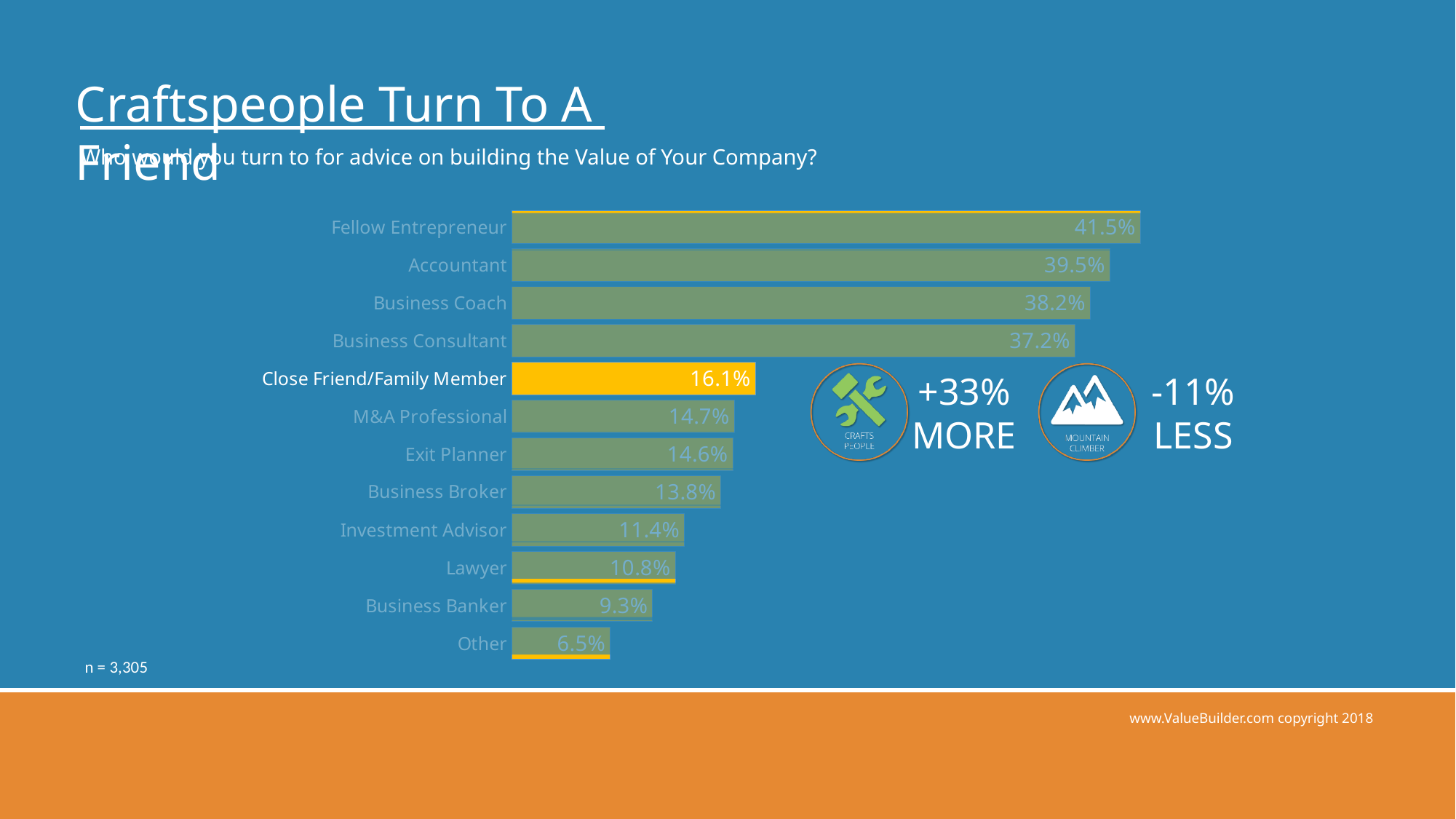
How many categories are shown in the chart? 12 What is the value shown for Close Friend/Family Member? 16.1% Which category has the highest value in the chart? Fellow Entrepreneur Which category has the lowest value in the chart? Other What type of chart is shown on the slide? Bar chart What is the difference between the values for Accountant and Business Coach? 1.3% What percentage of respondents would turn to a Fellow Entrepreneur for advice? 41.5% What is the difference between the values for Close Friend/Family Member and M&A Professional? 1.4% Which has a larger value, Investment Advisor or Lawyer? Investment Advisor Which bar in the chart is highlighted in yellow? Close Friend/Family Member What is the value shown for Business Banker? 9.3% Which has a larger value, Business Consultant or Exit Planner? Business Consultant